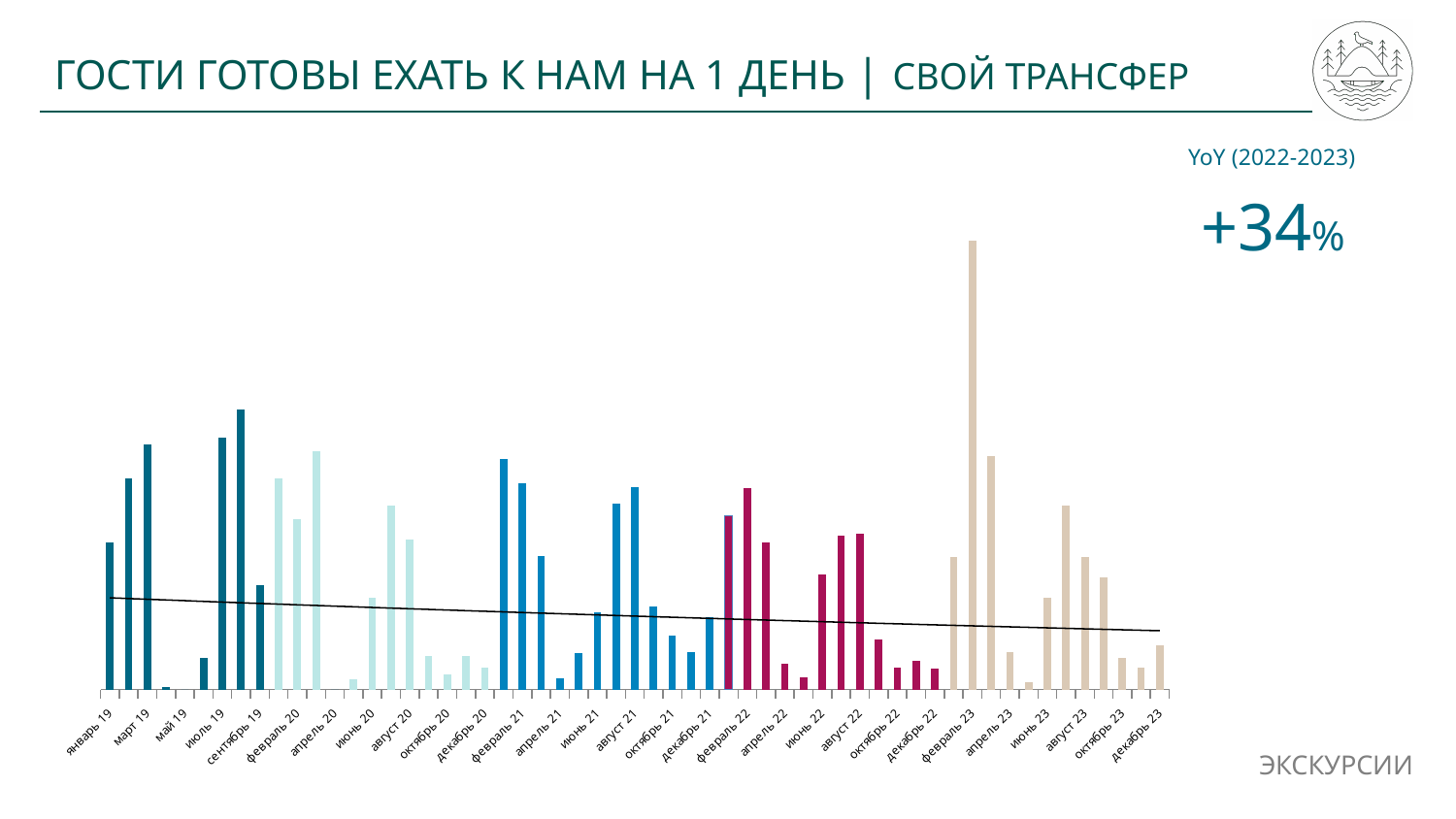
Which bar is taller: январь 19 or март 19? март 19 Which is taller: the tallest bar in 2023 or the tallest bar in 2019? the tallest bar in 2023 Which bar is taller: январь 19 or сентябрь 19? январь 19 What type of chart is shown on the slide? bar chart What is the first category label on the x axis? январь 19 Does the trend line drawn across the chart rise or fall from left to right? falls What YoY (2022-2023) change is shown on the slide? +34% In which year does the tallest bar on the chart appear? 2023